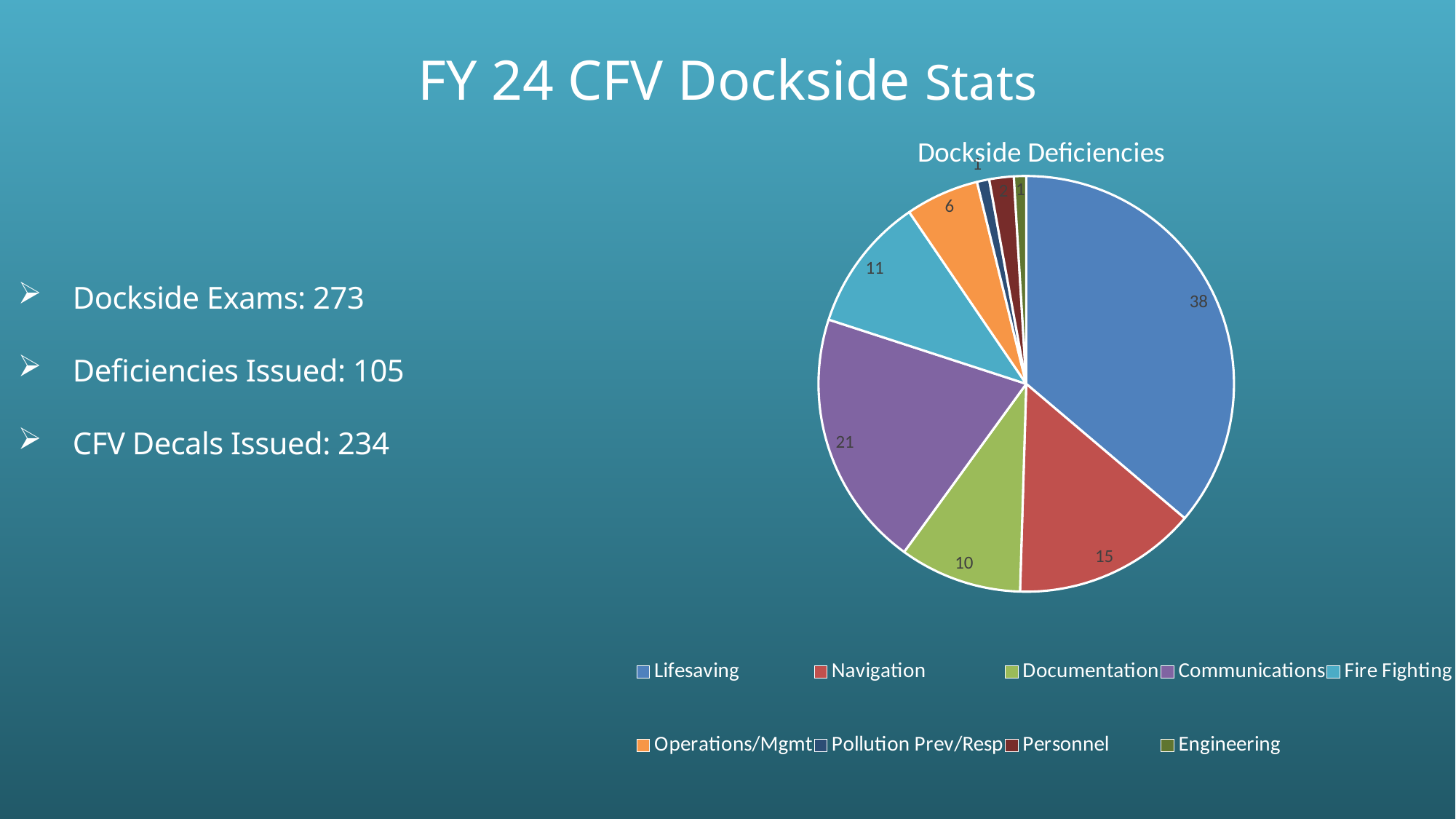
How many categories does the pie chart have? 9 What is the value for Operations/Mgmt? 6 What is the value for Communications in the Dockside Deficiencies chart? 21 What is the value for Fire Fighting? 11 What is the value for Navigation? 15 Which category has the largest slice of the pie? Lifesaving What is the total of all the slices in the pie chart? 105 What type of chart is shown on the slide? pie chart Which is larger, Documentation or Fire Fighting? Fire Fighting What is the title of the chart? Dockside Deficiencies How many deficiencies are shown for Lifesaving? 38 What is the difference between the Lifesaving and Navigation values? 23